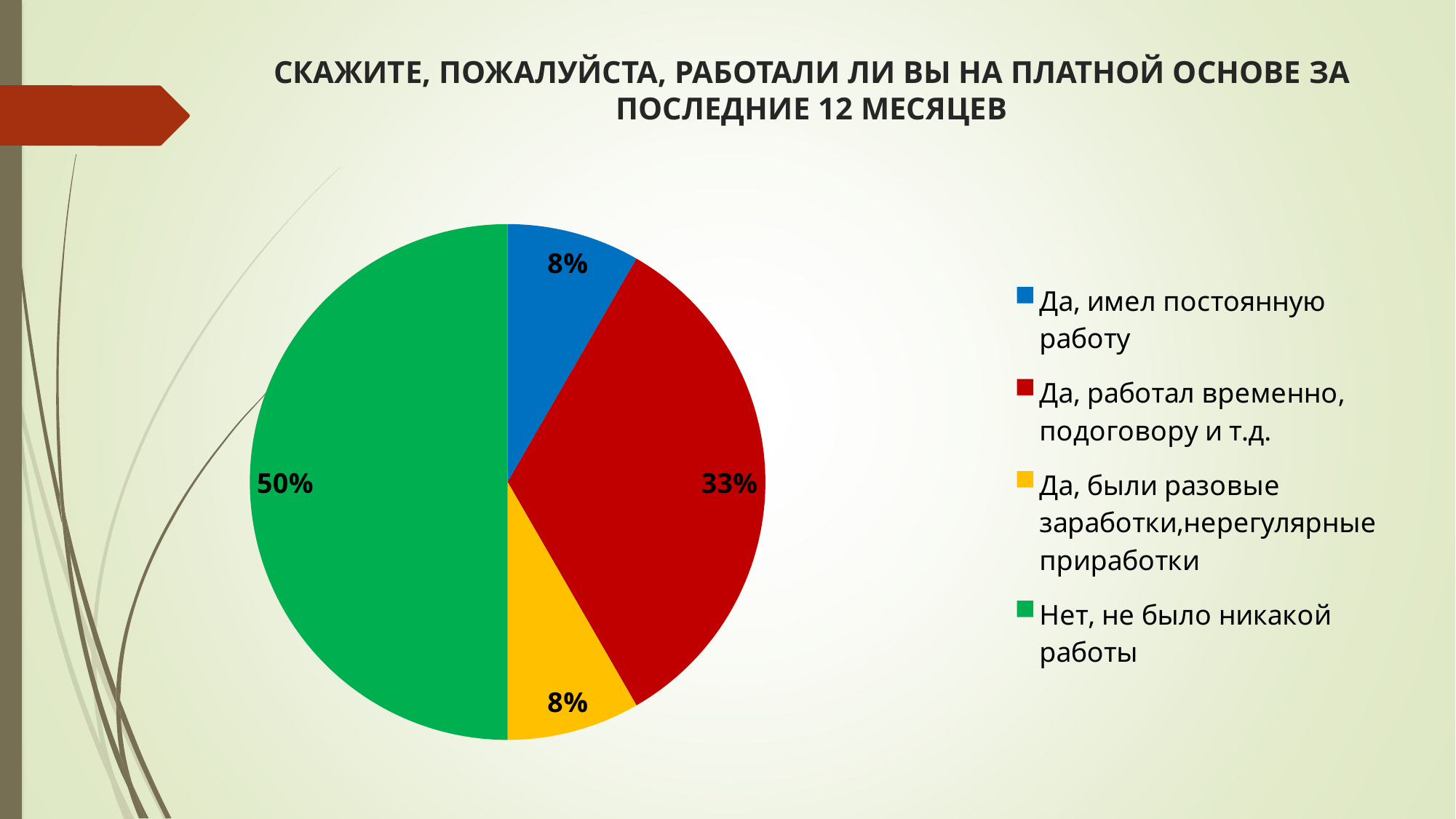
What kind of chart is shown on the slide? pie chart What share of the pie is labelled "Да, работал временно, подоговору и т.д."? 33% What is the title of the chart? СКАЖИТЕ, ПОЖАЛУЙСТА, РАБОТАЛИ ЛИ ВЫ НА ПЛАТНОЙ ОСНОВЕ ЗА ПОСЛЕДНИЕ 12 МЕСЯЦЕВ Which category has the largest slice of the pie? Нет, не было никакой работы How many slices does the pie chart have? 4 What colour is the slice for "Нет, не было никакой работы"? green What share of the pie is labelled "Нет, не было никакой работы"? 50% How many entries does the legend list? 4 What share of the pie is labelled "Да, имел постоянную работу"? 8% Which is larger: the share for "Да, работал временно, подоговору и т.д." or the share for "Да, имел постоянную работу"? Да, работал временно, подоговору и т.д. What share of the pie is labelled "Да, были разовые заработки,нерегулярные приработки"? 8% What is the difference between the share for "Нет, не было никакой работы" and the share for "Да, работал временно, подоговору и т.д."? 17%